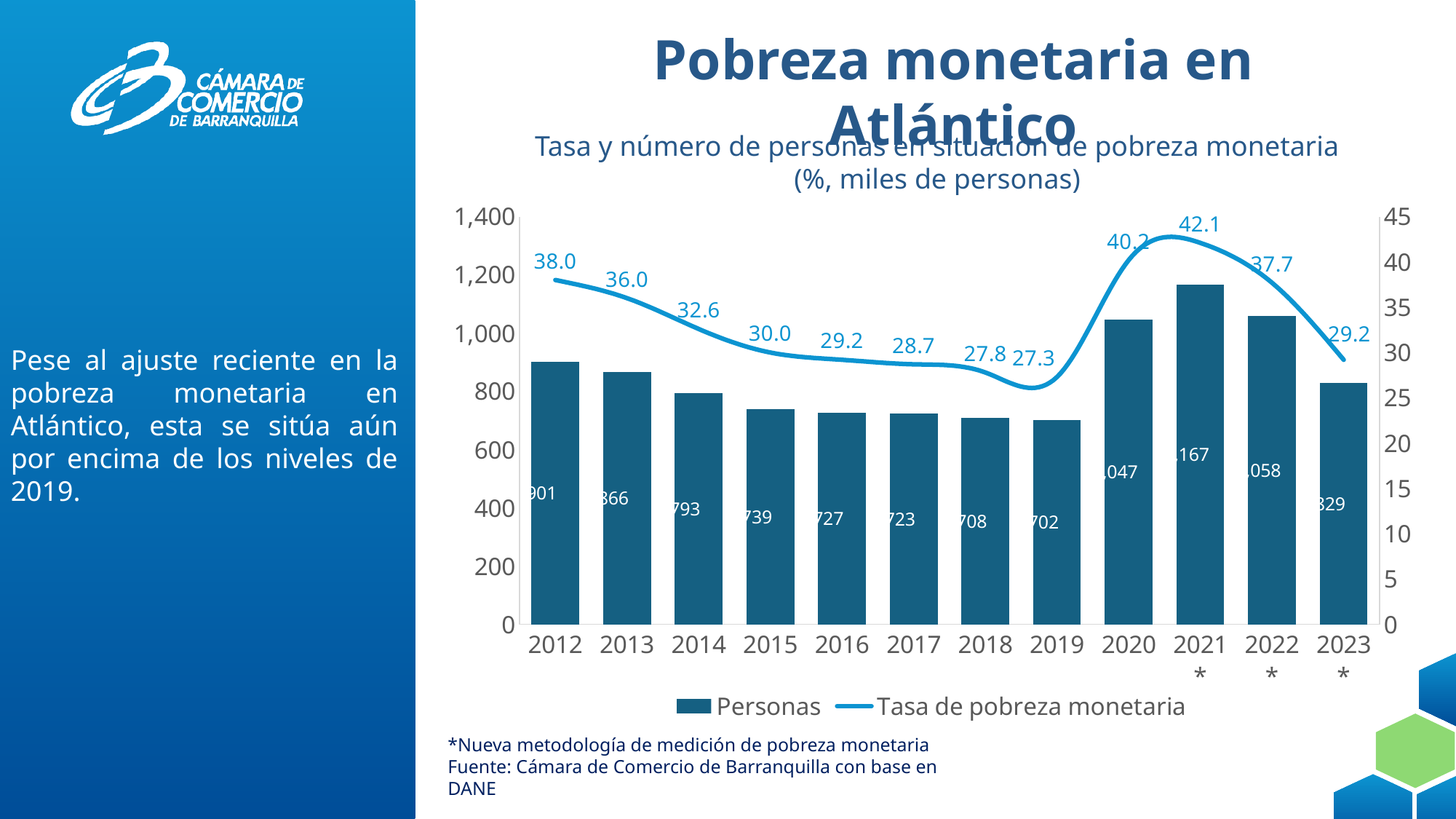
In which year is the Tasa de pobreza monetaria lowest? 2019 What is the Tasa de pobreza monetaria value for 2021*? 42.1 In which year is the Personas bar lowest? 2019 How many series does the legend list? 2 Which is larger, the Personas value for 2013 or for 2014? 2013 What is the difference between the Tasa de pobreza monetaria in 2012 and in 2019? 10.7 What is the Tasa de pobreza monetaria value for 2019? 27.3 How many years are shown on the x axis? 12 Is the Personas value for 2021* greater or less than 1,000? greater In which year is the Tasa de pobreza monetaria highest? 2021* What is the Personas value for 2019? 702 What is the Personas value for 2015? 739